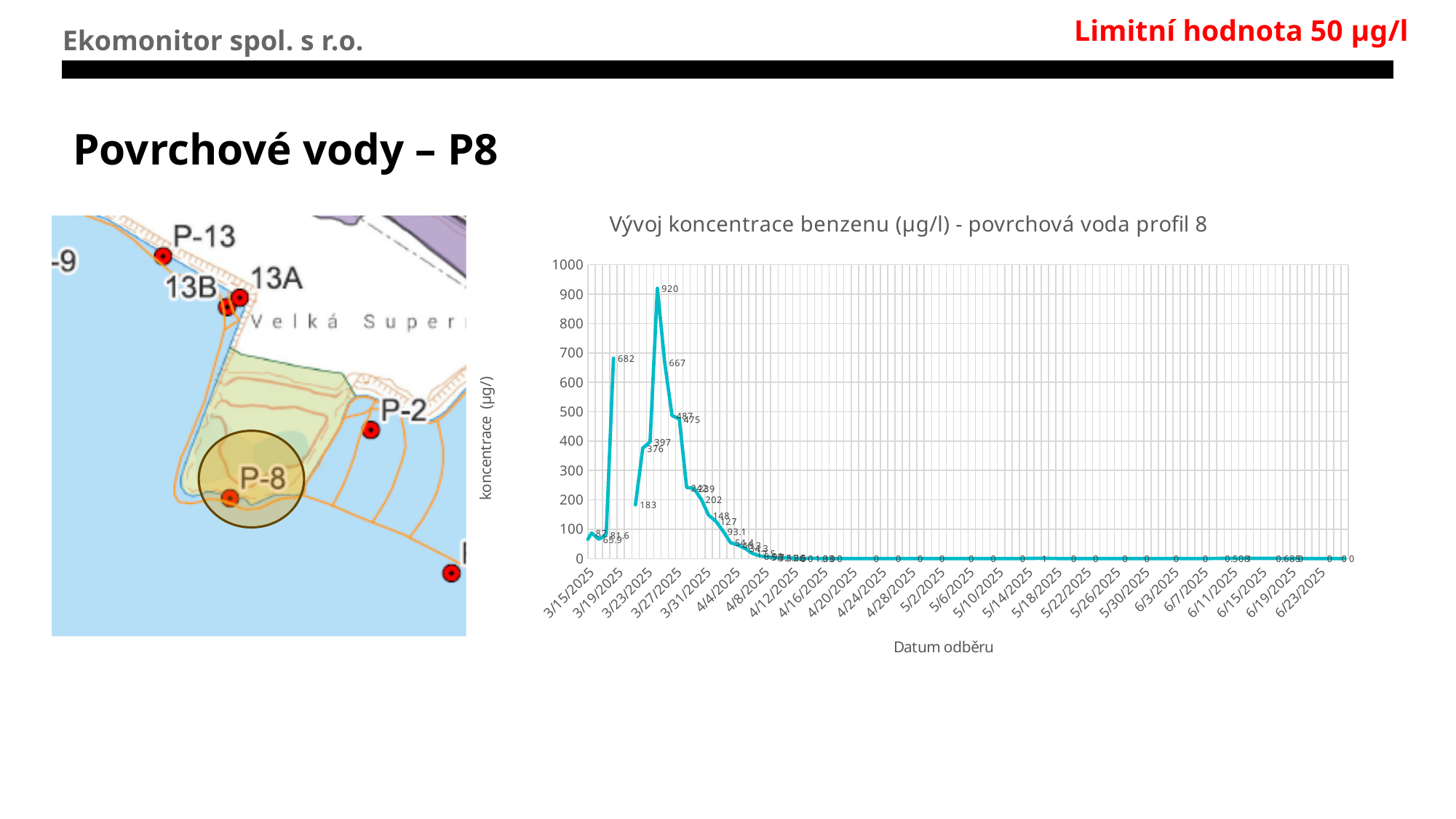
What is the highest labelled benzene concentration value on the chart? 920 What is the title of the chart? Vývoj koncentrace benzenu (µg/l) - povrchová voda profil 8 How many lines (data series) are plotted on the chart? 1 What is the label of the x axis of the chart? Datum odběru What is the last date label shown on the x axis? 6/23/2025 Which labelled value is larger, 920 or 682? 920 What kind of chart is shown on the slide? line chart What is the difference between the labelled values 920 and 667? 253 Is the value plotted at 5/2/2025 greater or less than 100? less Do the values rise or fall along the x axis from 3/27/2025 to 4/12/2025? fall What is the difference between the labelled values 682 and 487? 195 Is the peak value of the line greater or less than 900? greater